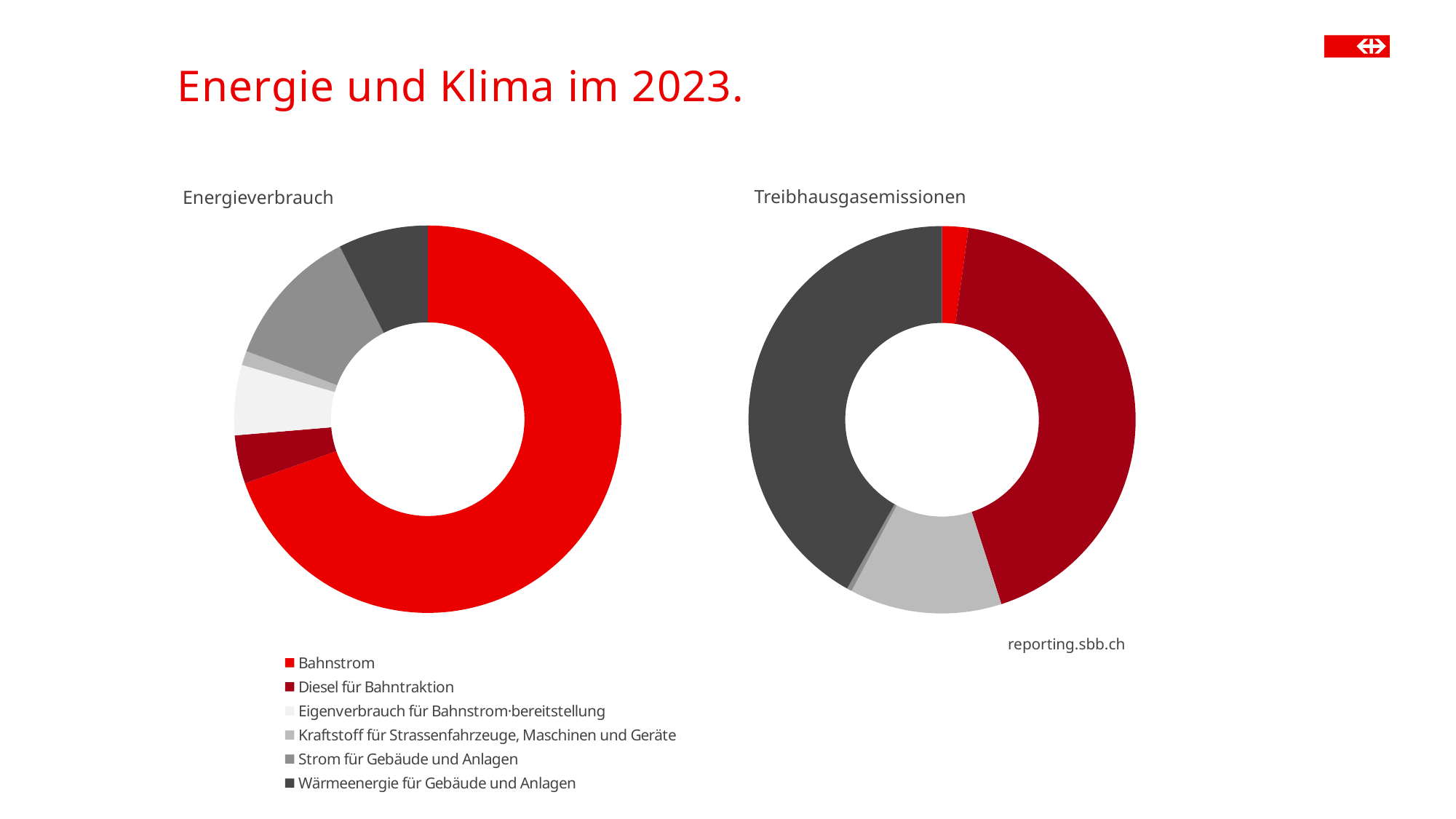
In the Energieverbrauch chart, which is larger: Strom für Gebäude und Anlagen or Kraftstoff für Strassenfahrzeuge, Maschinen und Geräte? Strom für Gebäude und Anlagen In the Treibhausgasemissionen chart, which is larger: Kraftstoff für Strassenfahrzeuge, Maschinen und Geräte or Bahnstrom? Kraftstoff für Strassenfahrzeuge, Maschinen und Geräte Which colour represents Bahnstrom in the legend? Red How many categories does the legend list for the charts? 6 In the Energieverbrauch chart, which is larger: Bahnstrom or Diesel für Bahntraktion? Bahnstrom In the Energieverbrauch chart, which category has the largest share? Bahnstrom In the Energieverbrauch chart, which category has the smallest share? Kraftstoff für Strassenfahrzeuge, Maschinen und Geräte How many charts are shown on the slide? 2 What kind of chart is the Energieverbrauch chart? Pie chart (donut) What is the title of the chart on the right? Treibhausgasemissionen